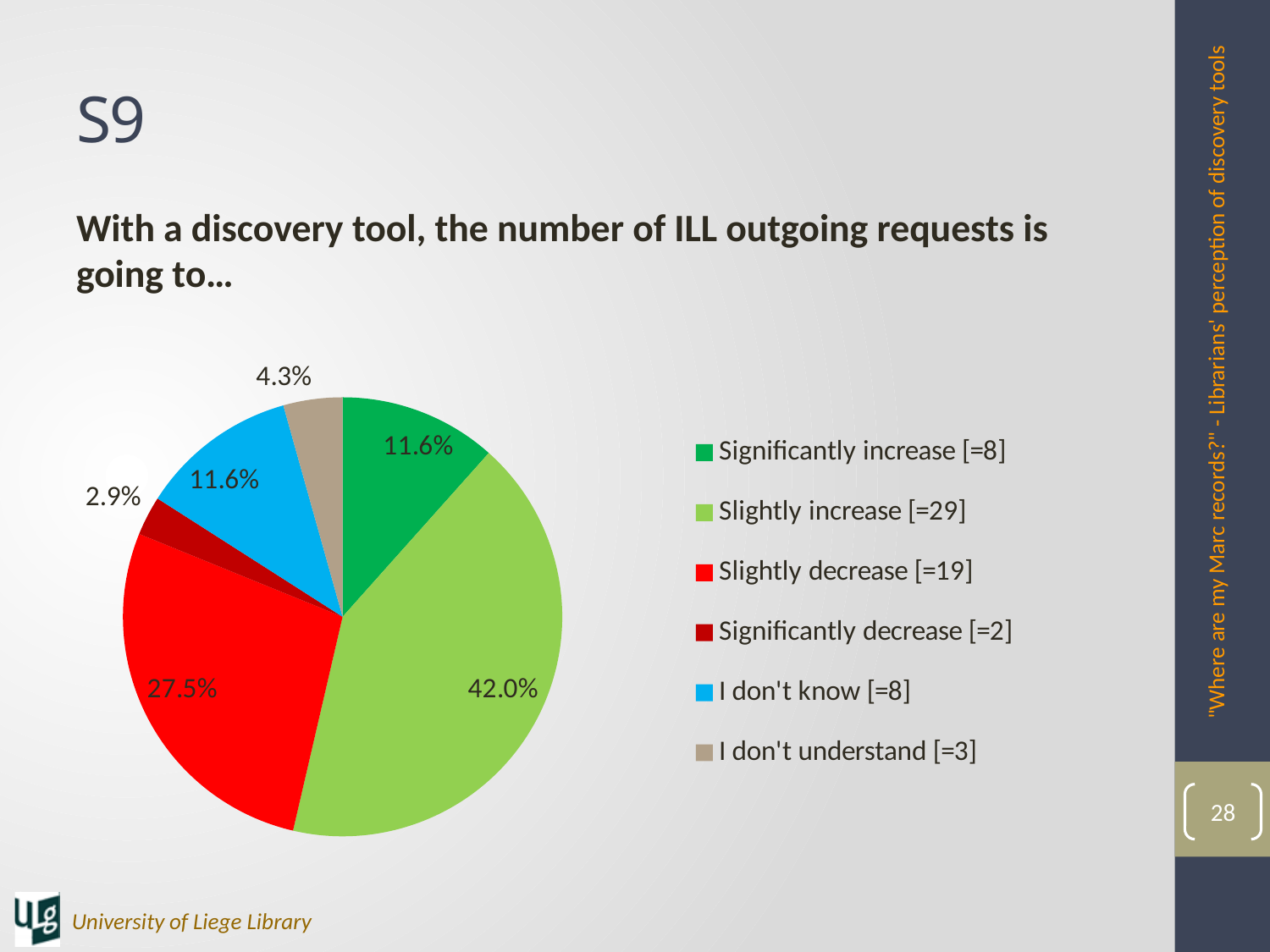
Which category has the largest slice of the pie? Slightly increase How many categories does the legend list? 6 What share of the pie does "I don't understand" represent? 4.3% What share of the pie does "Slightly increase" represent? 42.0% What share of the pie does "Slightly decrease" represent? 27.5% What is the difference in percentage points between "Slightly increase" and "Slightly decrease"? 14.5 How many respondents does the legend give for "Slightly increase"? 29 Which category has the smallest slice of the pie? Significantly decrease What kind of chart is shown on the slide? pie chart Which is larger, the slice for "I don't know" or the slice for "I don't understand"? I don't know What colour is the "Slightly decrease" slice? red